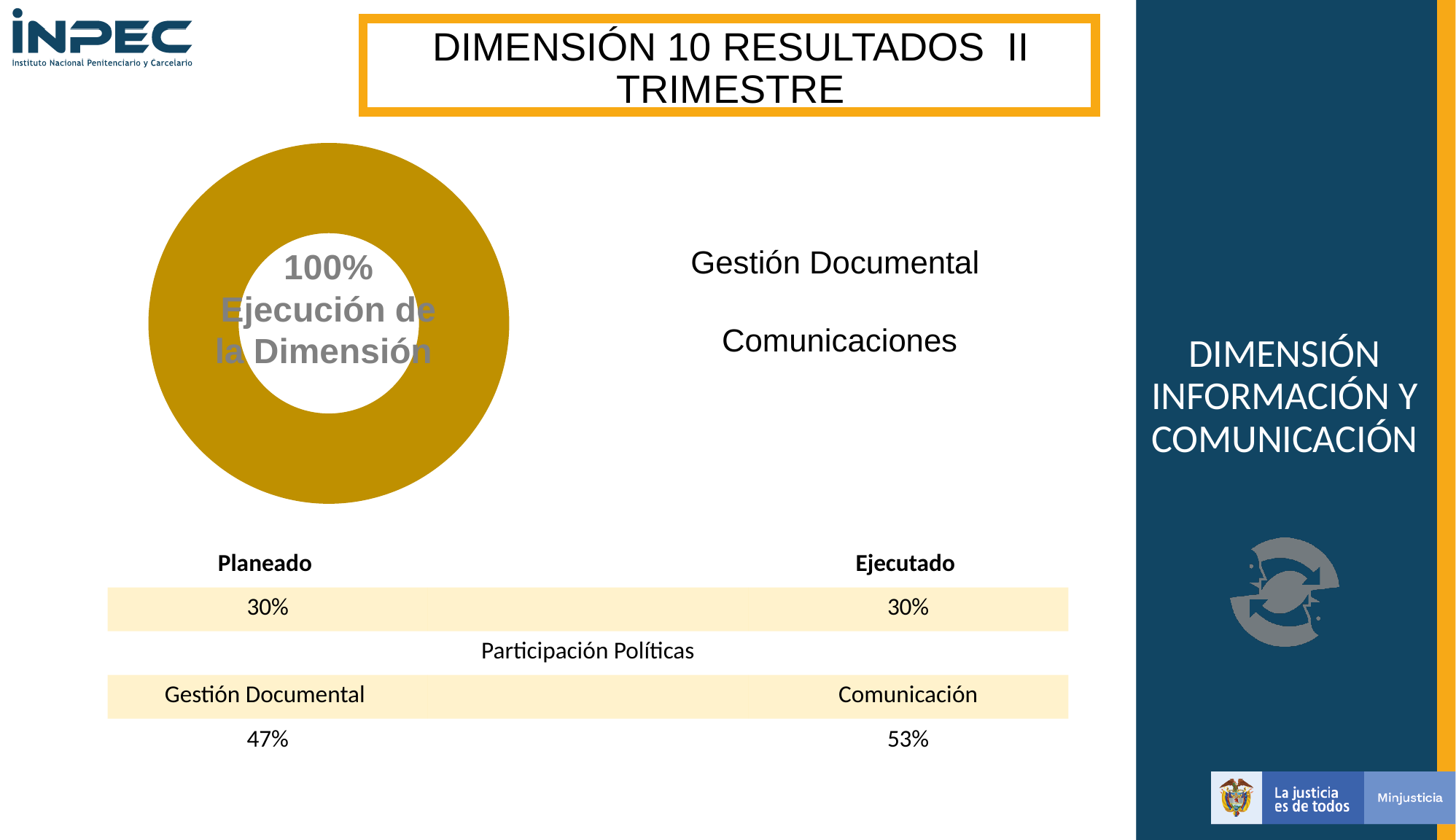
How many slices does the doughnut chart contain? 1 What percentage is printed in the centre of the doughnut chart? 100% What kind of chart is shown on the left of the slide? Doughnut (pie) chart What colour is the ring of the doughnut chart? Gold (dark yellow) What share of the doughnut chart does the single slice occupy? 100% What does the label inside the doughnut chart say the 100% represents? Ejecución de la Dimensión Is the value shown in the doughnut chart greater or less than 50%? greater